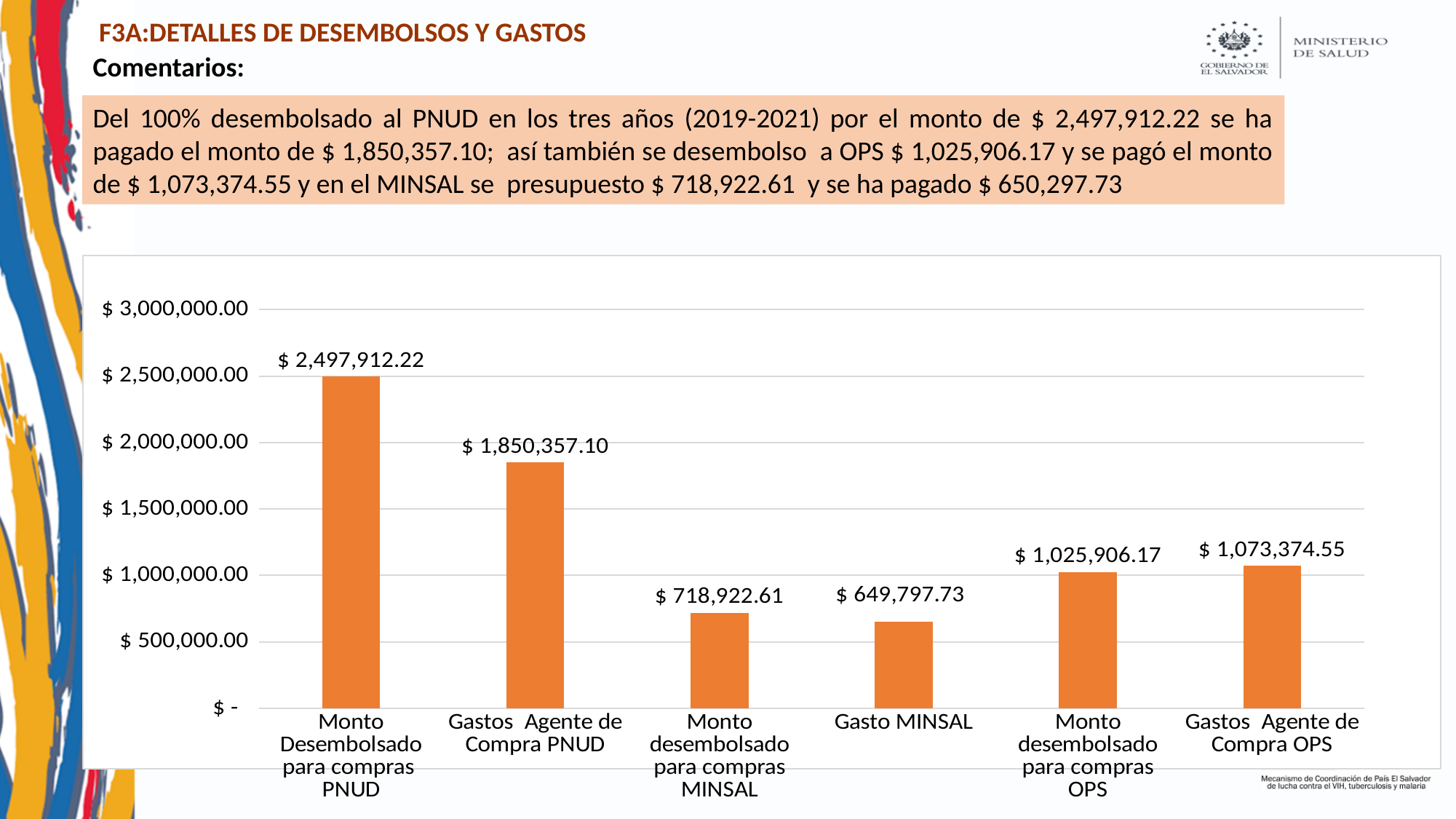
Which is larger: Monto desembolsado para compras MINSAL or Gasto MINSAL? Monto desembolsado para compras MINSAL What is the value for Monto Desembolsado para compras PNUD? $ 2,497,912.22 Which category has the highest value? Monto Desembolsado para compras PNUD How many categories are shown in the chart? 6 What kind of chart is shown on the slide? bar chart Is the value for Monto desembolsado para compras OPS greater or less than $ 1,000,000.00? greater What is the value for Gastos Agente de Compra OPS? $ 1,073,374.55 What is the value for Gasto MINSAL? $ 649,797.73 What is the difference between Monto Desembolsado para compras PNUD and Gastos Agente de Compra PNUD? $ 647,555.12 What is the difference between Gastos Agente de Compra OPS and Monto desembolsado para compras OPS? $ 47,468.38 What is the value for Gastos Agente de Compra PNUD? $ 1,850,357.10 Which category has the lowest value? Gasto MINSAL